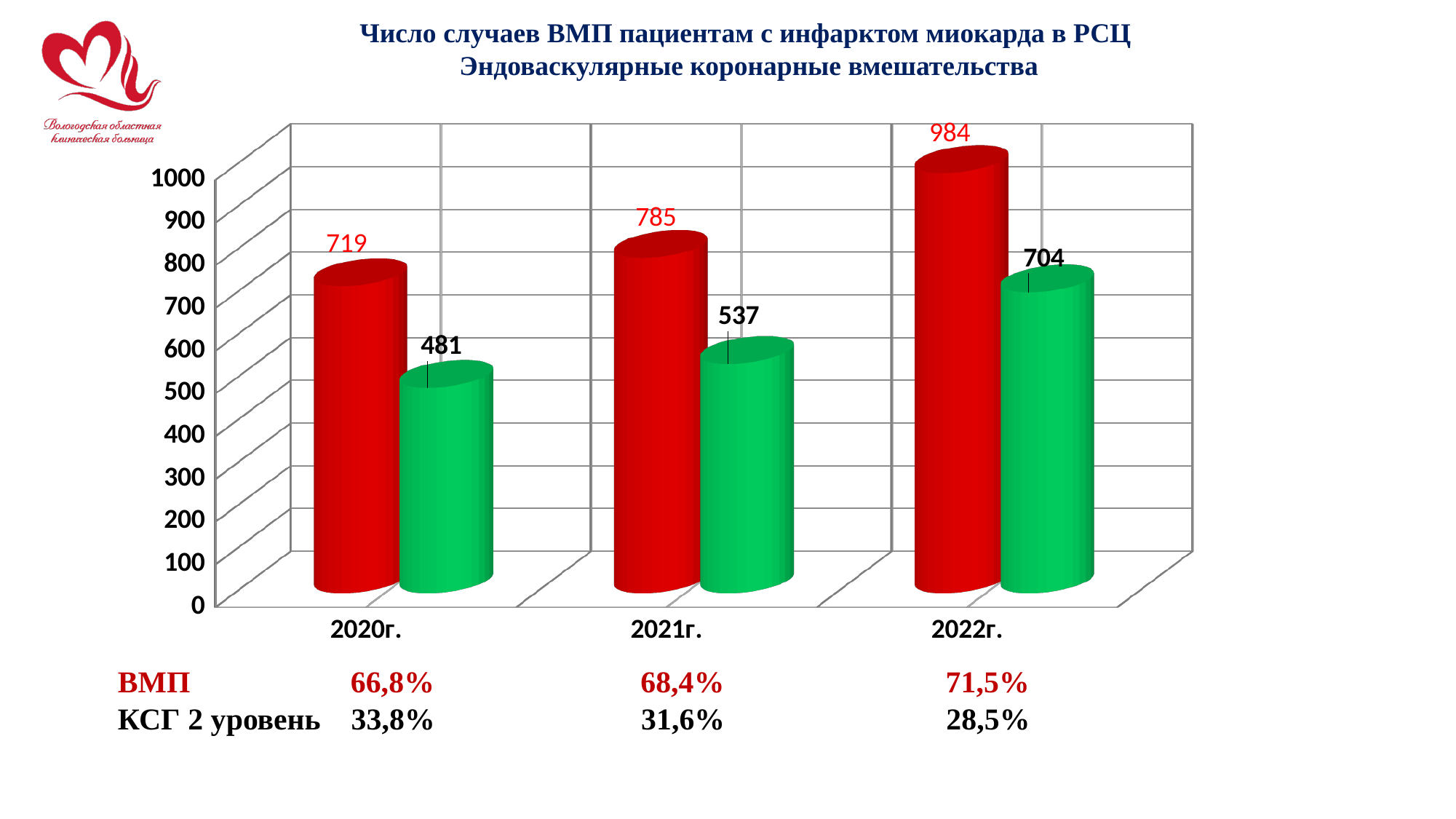
Which is larger: the green bar for 2022г. or the red bar for 2020г.? The red bar for 2020г. By how much did the red bar increase from 2020г. to 2022г.? 265 What is the value of the red bar for 2022г.? 984 What kind of chart is shown on the slide? Bar chart What is the value of the green bar for 2021г.? 537 What is the value of the green bar for 2022г.? 704 What is the difference between the red bar and the green bar for 2021г.? 248 Do the green bar values rise or fall from 2020г. to 2022г.? Rise What is the value of the red bar for 2020г.? 719 In which year is the red bar highest? 2022г. In which year is the green bar lowest? 2020г. How many years are shown on the x axis? 3